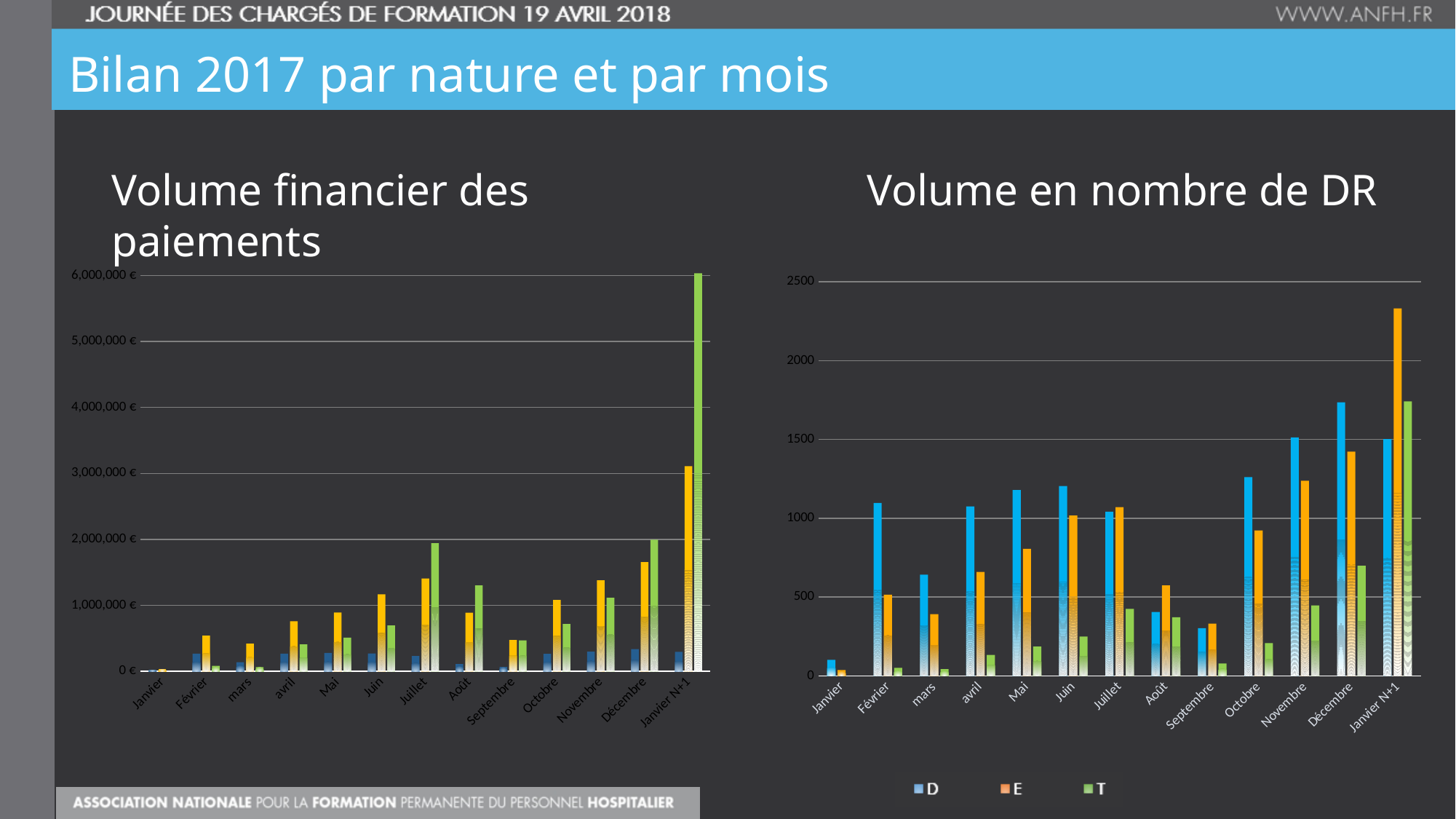
In the 'Volume en nombre de DR' chart, which month has the highest value for series D? Décembre In the 'Volume financier des paiements' chart, which month has a taller orange bar: Juin or Septembre? Juin How many series does the legend of the 'Volume en nombre de DR' chart list? 3 In the 'Volume en nombre de DR' chart, which month has the lowest value for series D? Janvier How many months (categories) are shown on the x axis of the 'Volume financier des paiements' chart? 13 In the 'Volume en nombre de DR' chart, is the value of series D for Décembre greater or less than 1500? greater In the 'Volume en nombre de DR' chart, which is larger for Octobre: series E or series T? E In the 'Volume en nombre de DR' chart, is the value of series E for Janvier N+1 greater or less than 2000? greater In the 'Volume en nombre de DR' chart, which month has the highest value for series E? Janvier N+1 In the 'Volume financier des paiements' chart, which month has the tallest green bar? Janvier N+1 In the 'Volume financier des paiements' chart, is the green bar for Janvier N+1 greater or less than 5,000,000 €? greater What kind of chart is the 'Volume en nombre de DR' chart? bar chart